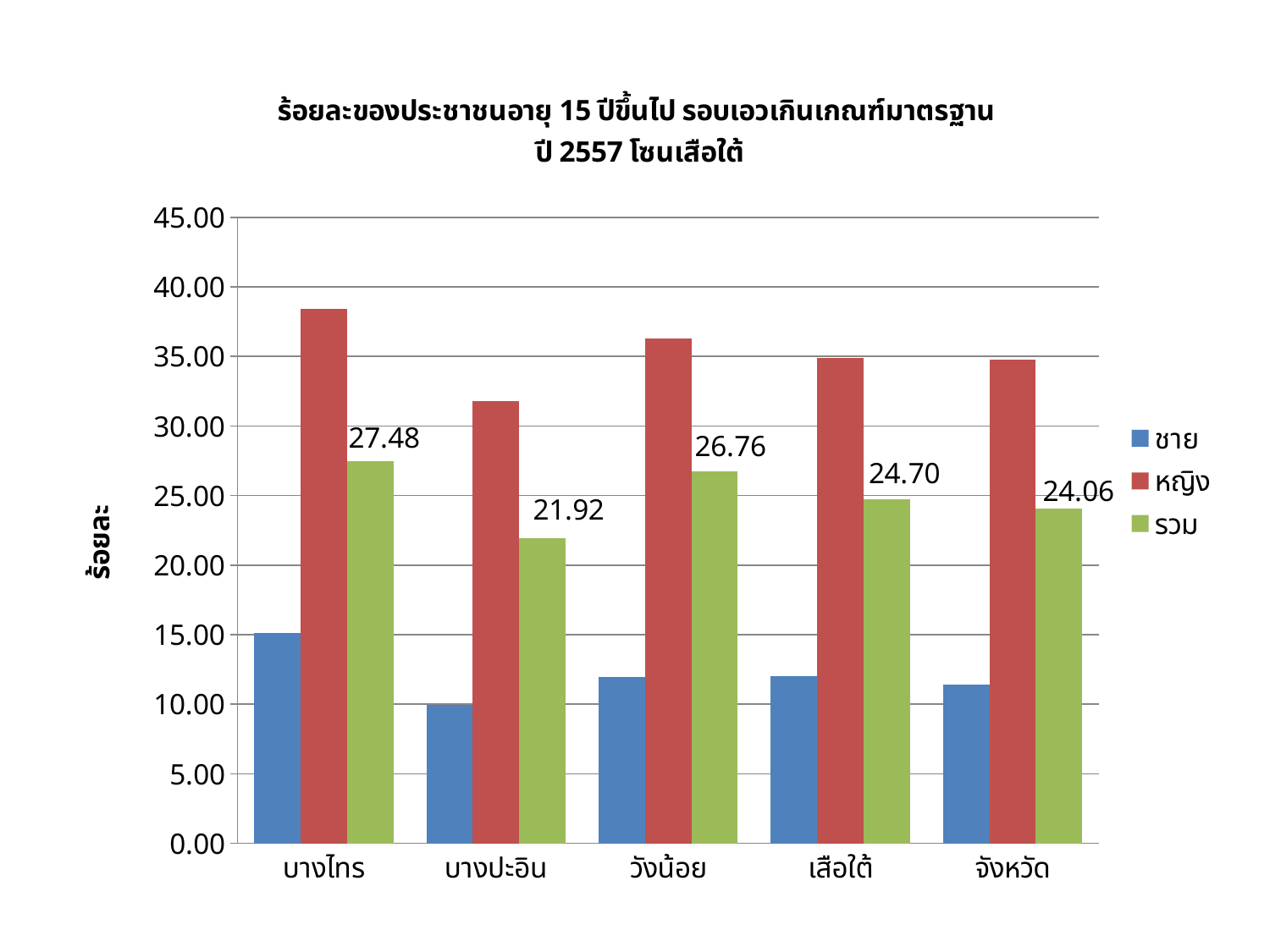
Is the value of ชาย for บางปะอิน greater or less than 15.00? less What is the difference between the รวม values for บางไทร and บางปะอิน? 5.56 Which category has the highest รวม value? บางไทร What is the value of รวม for บางไทร? 27.48 Which category has the lowest รวม value? บางปะอิน What is the value of รวม for บางปะอิน? 21.92 Is the รวม value for เสือใต้ larger than the รวม value for จังหวัด? Yes What is the value of รวม for จังหวัด? 24.06 Is the value of หญิง for บางไทร greater or less than 35.00? greater What is the value of รวม for วังน้อย? 26.76 How many series does the legend list? 3 How many categories are shown on the x axis? 5